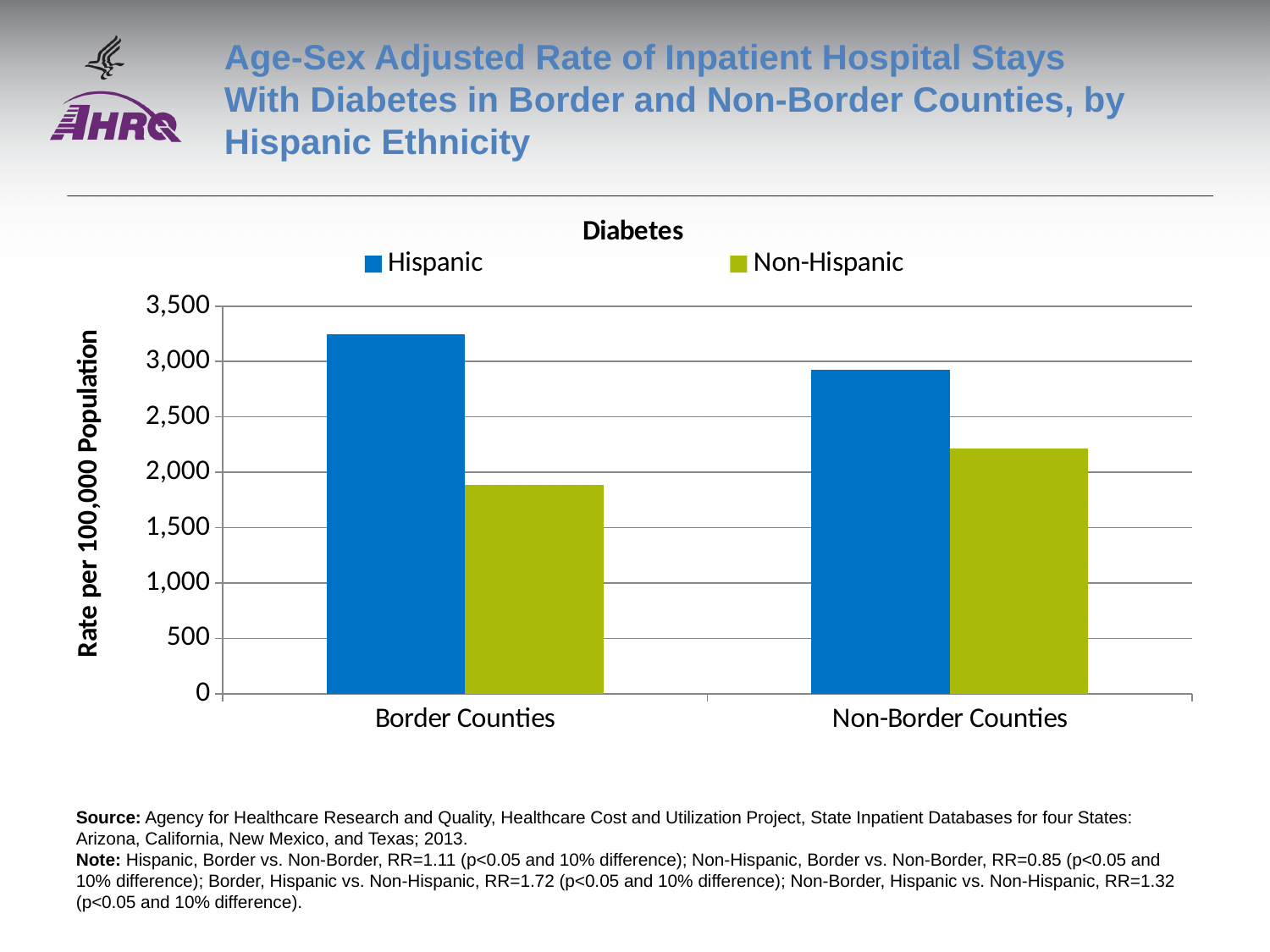
For the Non-Hispanic series, which category has the larger value: Border Counties or Non-Border Counties? Non-Border Counties Is the Non-Hispanic value for Non-Border Counties greater or less than 2,000? greater How many categories are shown on the x axis? 2 What is the label of the y axis? Rate per 100,000 Population Which bar is the lowest in the chart? Non-Hispanic, Border Counties Which bar is the highest in the chart? Hispanic, Border Counties What kind of chart is shown on the slide? Bar chart In Non-Border Counties, which is larger: the Hispanic or the Non-Hispanic rate? Hispanic Is the Hispanic value for Border Counties greater or less than 3,000? greater How many series does the legend list? 2 Is the Hispanic value for Non-Border Counties greater or less than 3,000? less